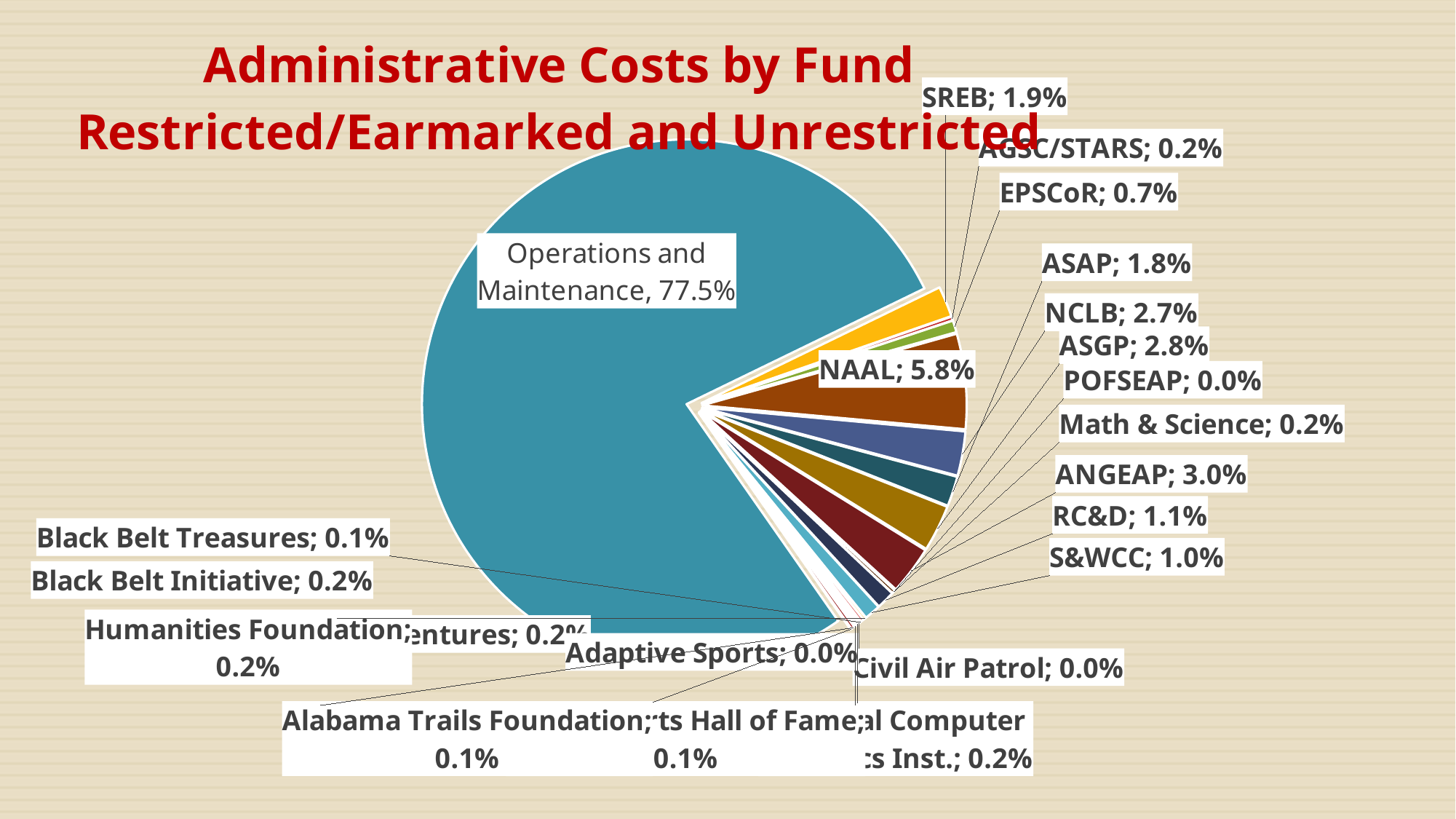
What type of chart is shown on the slide? pie chart Which is larger, the share for ASGP or the share for NCLB? ASGP What is the value shown for NAAL? 5.8% What is the difference between the ASAP share and the SREB share? 0.1% What share of administrative costs goes to Operations and Maintenance? 77.5% Which fund has the largest slice of the pie? Operations and Maintenance What is the value for SREB? 1.9% What percentage is shown for EPSCoR? 0.7% Which is larger, the share for RC&D or the share for S&WCC? RC&D What is the title of the chart? Administrative Costs by Fund Restricted/Earmarked and Unrestricted What percentage is shown for ANGEAP? 3.0% What is the difference between the NAAL share and the ANGEAP share? 2.8%